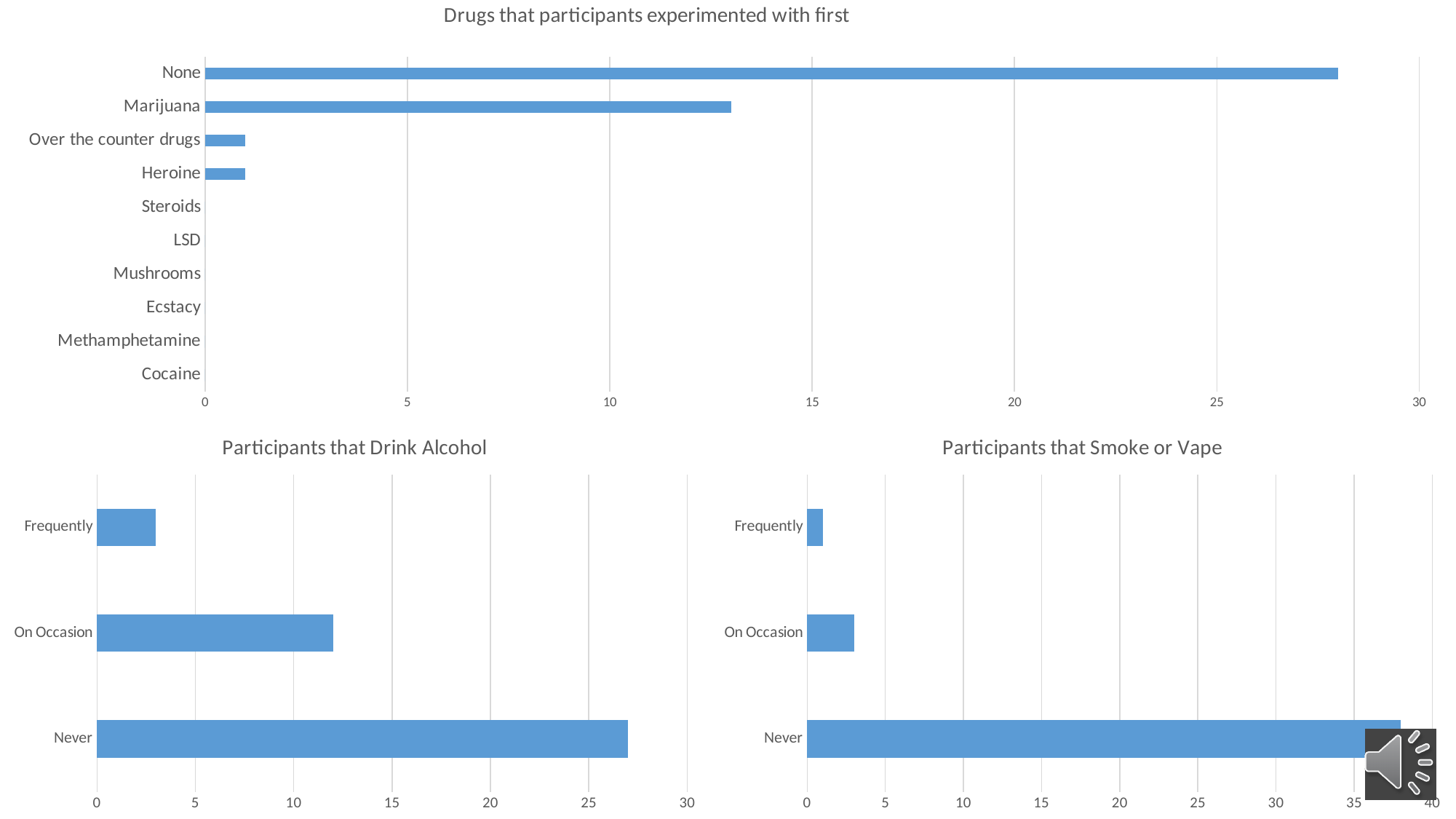
In 'Drugs that participants experimented with first', which is larger, Marijuana or Heroine? Marijuana In 'Participants that Drink Alcohol', is the value for On Occasion greater or less than 10? greater In 'Participants that Smoke or Vape', is the value for Never greater or less than 35? greater In 'Drugs that participants experimented with first', is the value for None greater or less than 25? greater How many categories are listed in 'Drugs that participants experimented with first'? 10 In 'Participants that Drink Alcohol', which category has the lowest value? Frequently What kind of chart is 'Drugs that participants experimented with first'? bar chart How many categories does 'Participants that Smoke or Vape' show? 3 In 'Participants that Smoke or Vape', which is larger, Frequently or On Occasion? On Occasion In 'Participants that Drink Alcohol', which category has the highest value? Never In 'Drugs that participants experimented with first', which category has the highest value? None